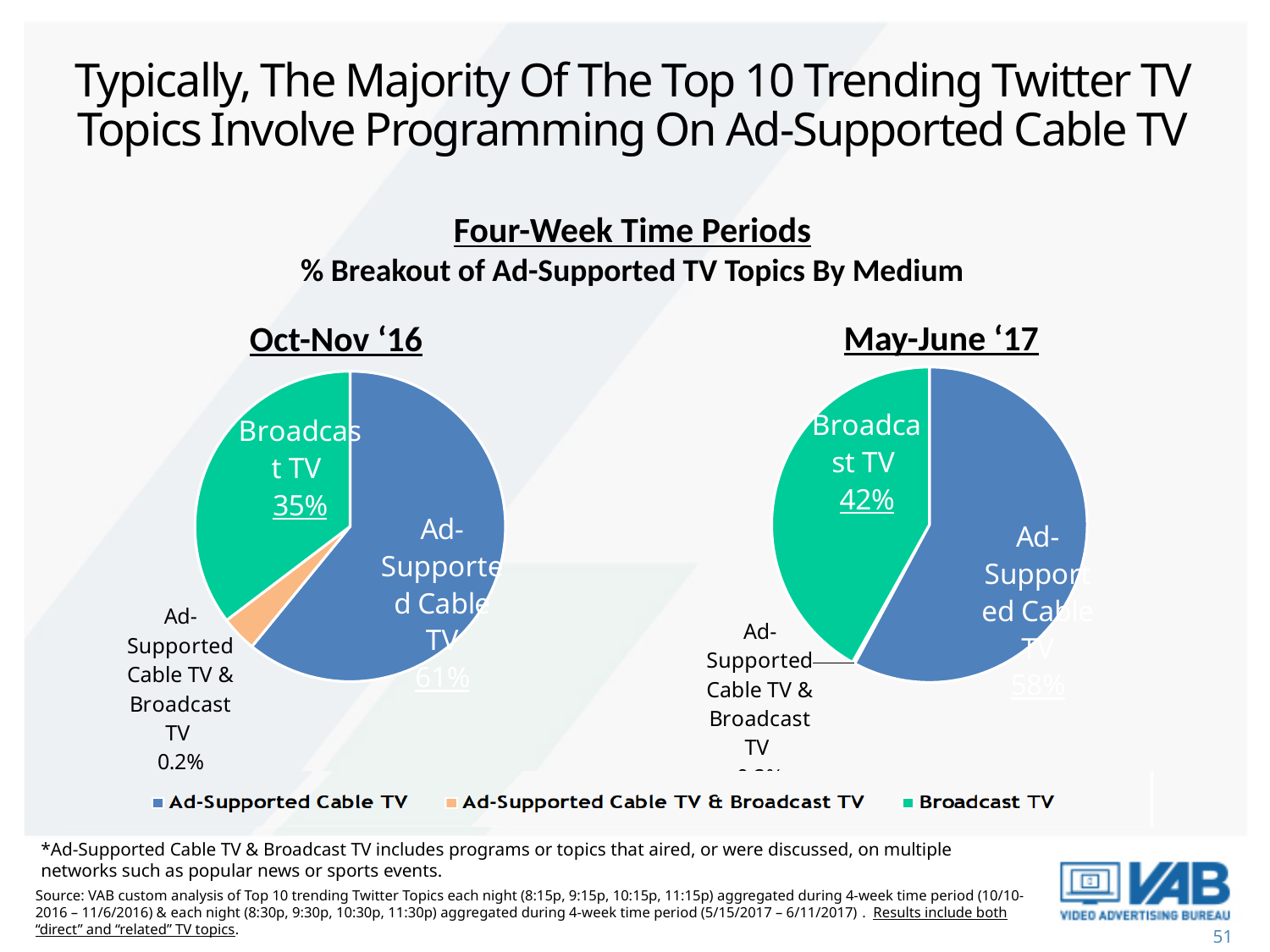
In the Oct-Nov '16 pie chart, what share is Ad-Supported Cable TV & Broadcast TV? 0.2% In the May-June '17 pie chart, which is larger, Ad-Supported Cable TV or Broadcast TV? Ad-Supported Cable TV In the Oct-Nov '16 pie chart, which category has the largest share? Ad-Supported Cable TV In the May-June '17 pie chart, what share is Ad-Supported Cable TV? 58% How many entries does the shared legend below the charts list? 3 What kind of chart is used for the Oct-Nov '16 data? Pie chart In the Oct-Nov '16 pie chart, what share is Ad-Supported Cable TV? 61% In the May-June '17 pie chart, what share is Broadcast TV? 42% In the Oct-Nov '16 pie chart, which category has the smallest share? Ad-Supported Cable TV & Broadcast TV In the Oct-Nov '16 pie chart, what is the difference between the Ad-Supported Cable TV share and the Broadcast TV share? 26% In the Oct-Nov '16 pie chart, what share is Broadcast TV? 35% In the May-June '17 pie chart, what is the difference between the Ad-Supported Cable TV share and the Broadcast TV share? 16%